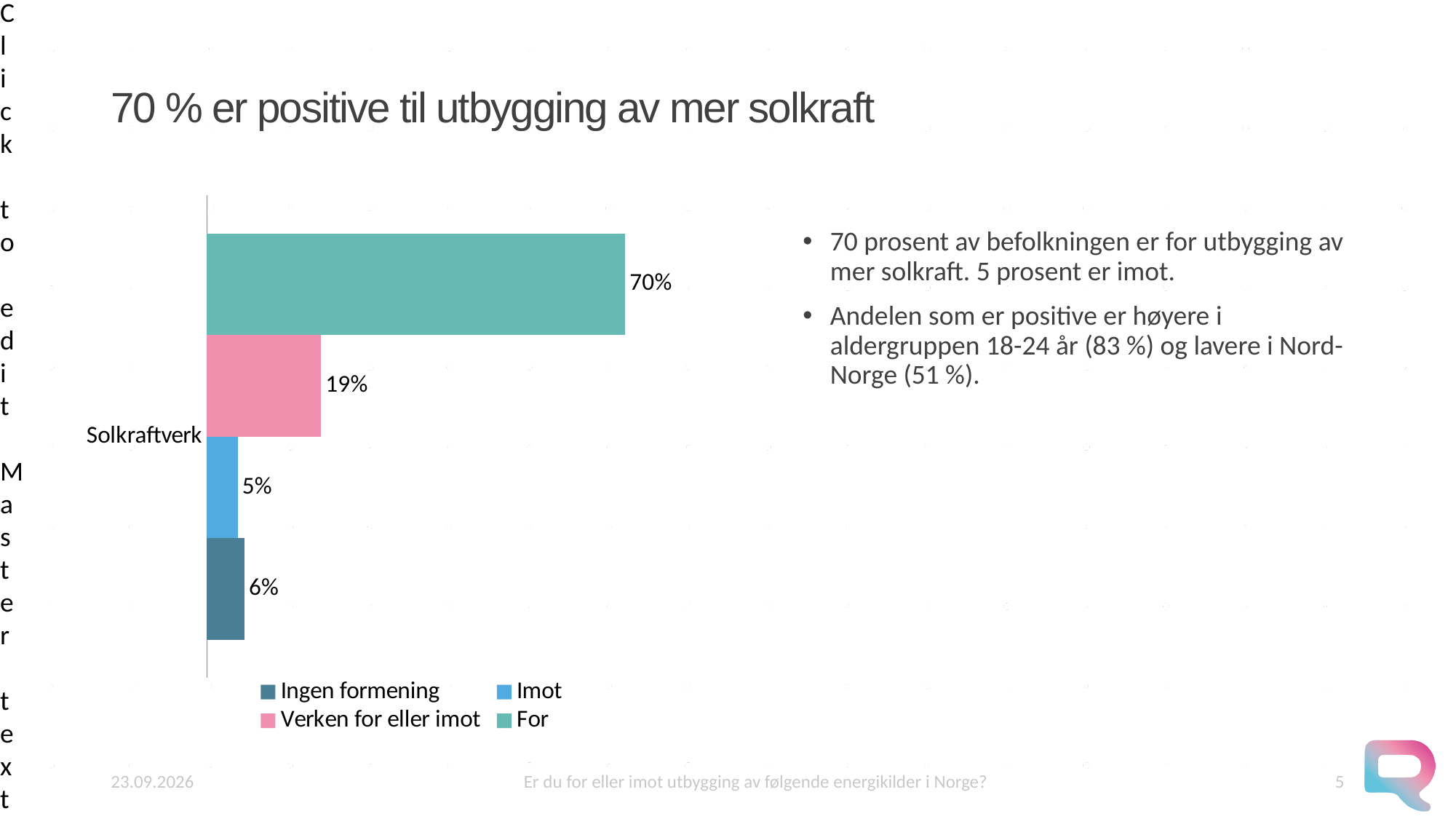
What is the value for the "For" series for Solkraftverk? 70% How many series does the legend list? 4 What is the value for "Ingen formening" for Solkraftverk? 6% Which series has the lowest value for Solkraftverk? Imot What kind of chart is shown on the slide? Bar chart What colour is the bar for the "For" series? Teal Which series has the highest value for Solkraftverk? For What is the difference between the "Verken for eller imot" value and the "Ingen formening" value? 13 percentage points What is the difference between the "For" value and the "Imot" value for Solkraftverk? 65 percentage points What is the value for "Verken for eller imot" for Solkraftverk? 19% Which is larger for Solkraftverk: "Ingen formening" or "Imot"? Ingen formening What is the value for "Imot" for Solkraftverk? 5%